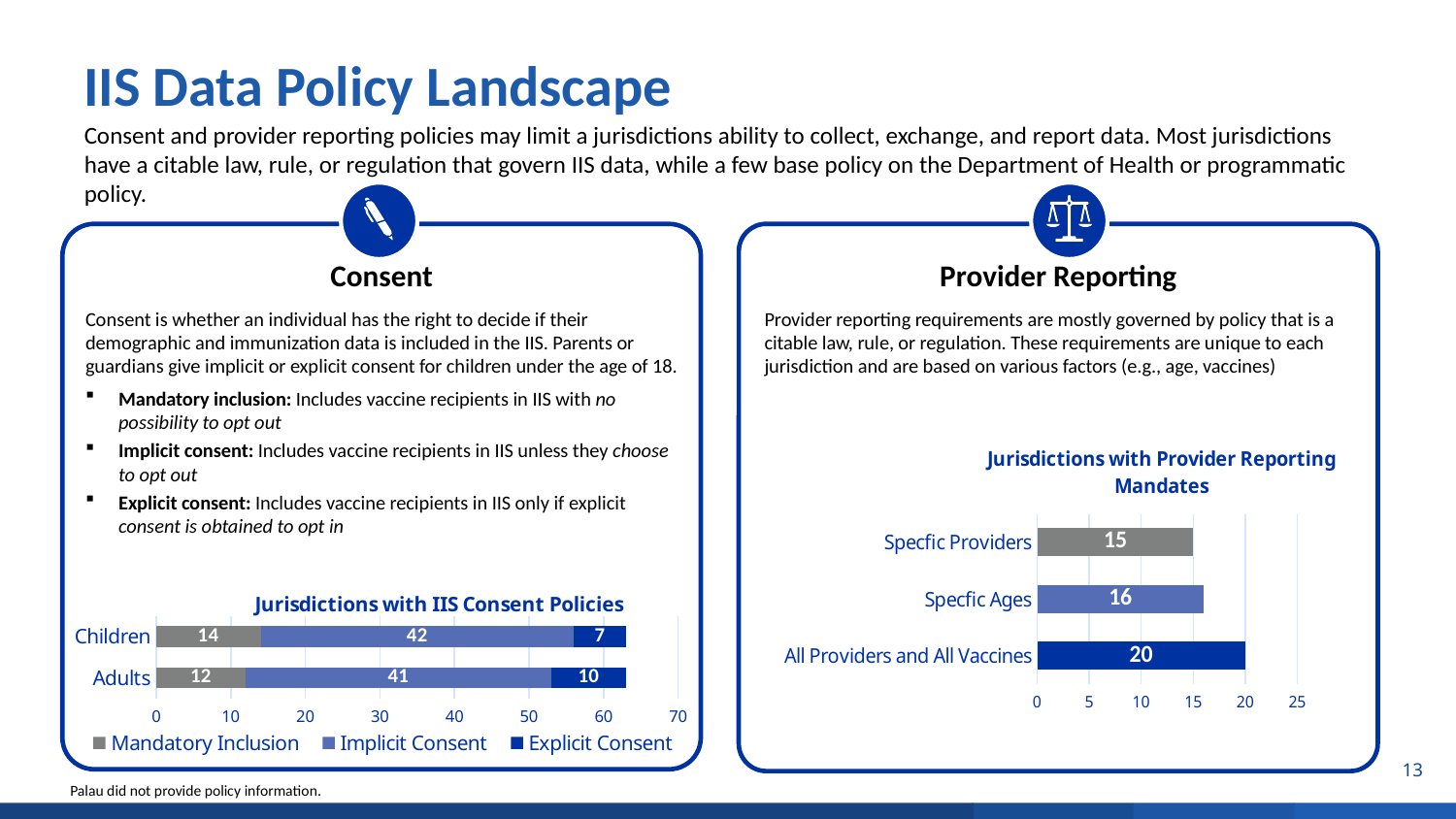
What kind of chart is the 'Jurisdictions with Provider Reporting Mandates' chart? Bar chart In the 'Jurisdictions with Provider Reporting Mandates' chart, what is the value for Specific Providers? 15 In the 'Jurisdictions with IIS Consent Policies' chart, how many series does the legend list? 3 In the 'Jurisdictions with IIS Consent Policies' chart, what is the Implicit Consent value for Children? 42 In the 'Jurisdictions with IIS Consent Policies' chart, what is the difference between the Implicit Consent values for Children and Adults? 1 In the 'Jurisdictions with IIS Consent Policies' chart, what is the Mandatory Inclusion value for Children? 14 In the 'Jurisdictions with Provider Reporting Mandates' chart, what is the difference between All Providers and All Vaccines and Specific Ages? 4 In the 'Jurisdictions with IIS Consent Policies' chart, what is the Explicit Consent value for Adults? 10 In the 'Jurisdictions with IIS Consent Policies' chart, what is the total of the stacked bar for Adults? 63 In the 'Jurisdictions with Provider Reporting Mandates' chart, which category has the highest value? All Providers and All Vaccines In the 'Jurisdictions with Provider Reporting Mandates' chart, which category has the lowest value? Specific Providers In the 'Jurisdictions with IIS Consent Policies' chart, which is larger: the Explicit Consent value for Children or for Adults? Adults